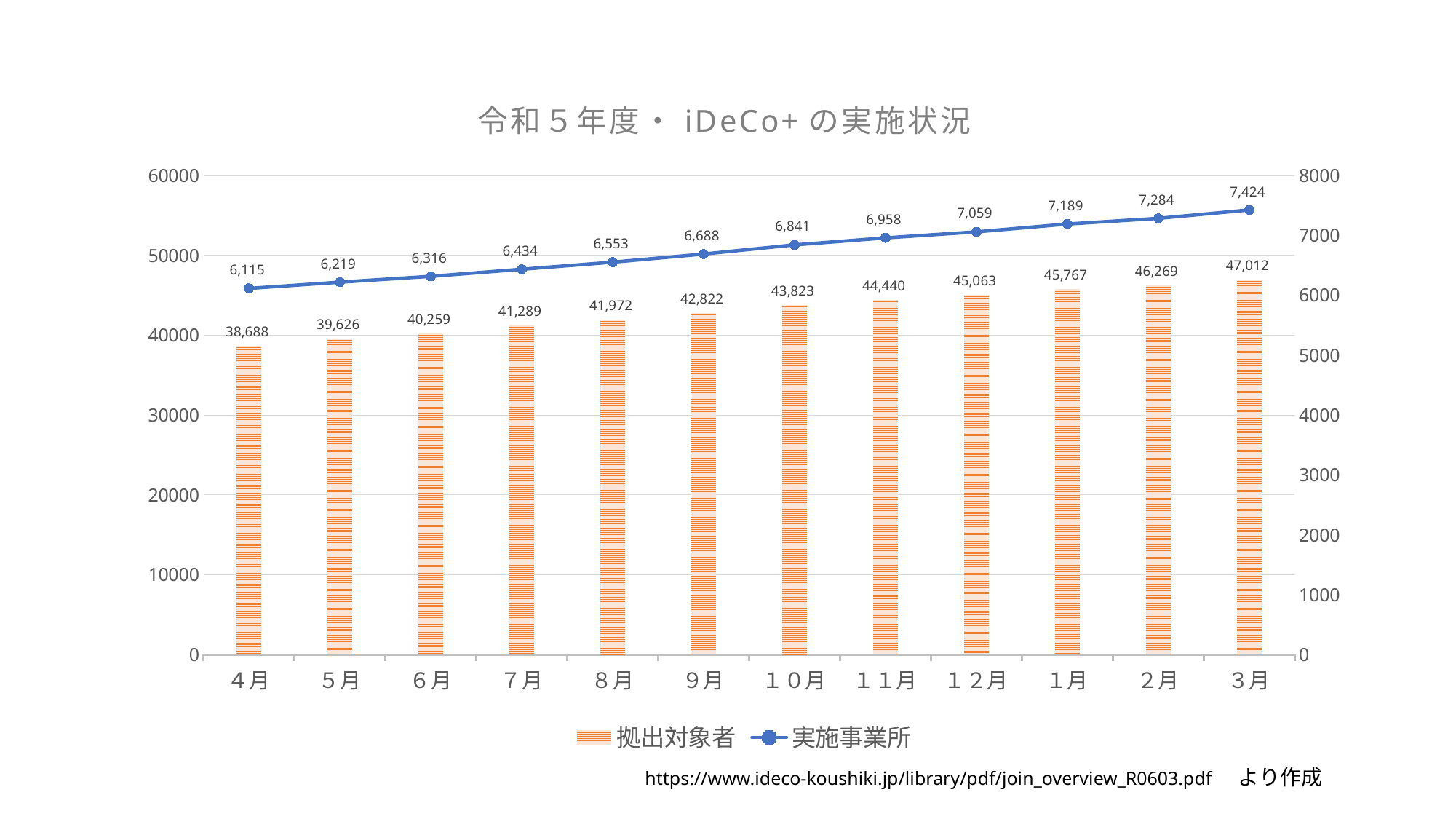
Which month has the lowest value of 実施事業所? 4月 How many series does the legend list? 2 How many months are shown on the x axis? 12 Do the 実施事業所 values rise or fall from 4月 to 3月? rise What is the value of 実施事業所 for 3月? 7,424 What is the value of 実施事業所 for 9月? 6,688 What is the difference in 実施事業所 between 12月 and 11月? 101 Which is larger, the 拠出対象者 value for 10月 or for 8月? 10月 What is the value of 拠出対象者 for 4月? 38,688 What is the difference in 拠出対象者 between 3月 and 4月? 8,324 Which month has the highest value of 拠出対象者? 3月 What is the title of the chart? 令和５年度・iDeCo+の実施状況